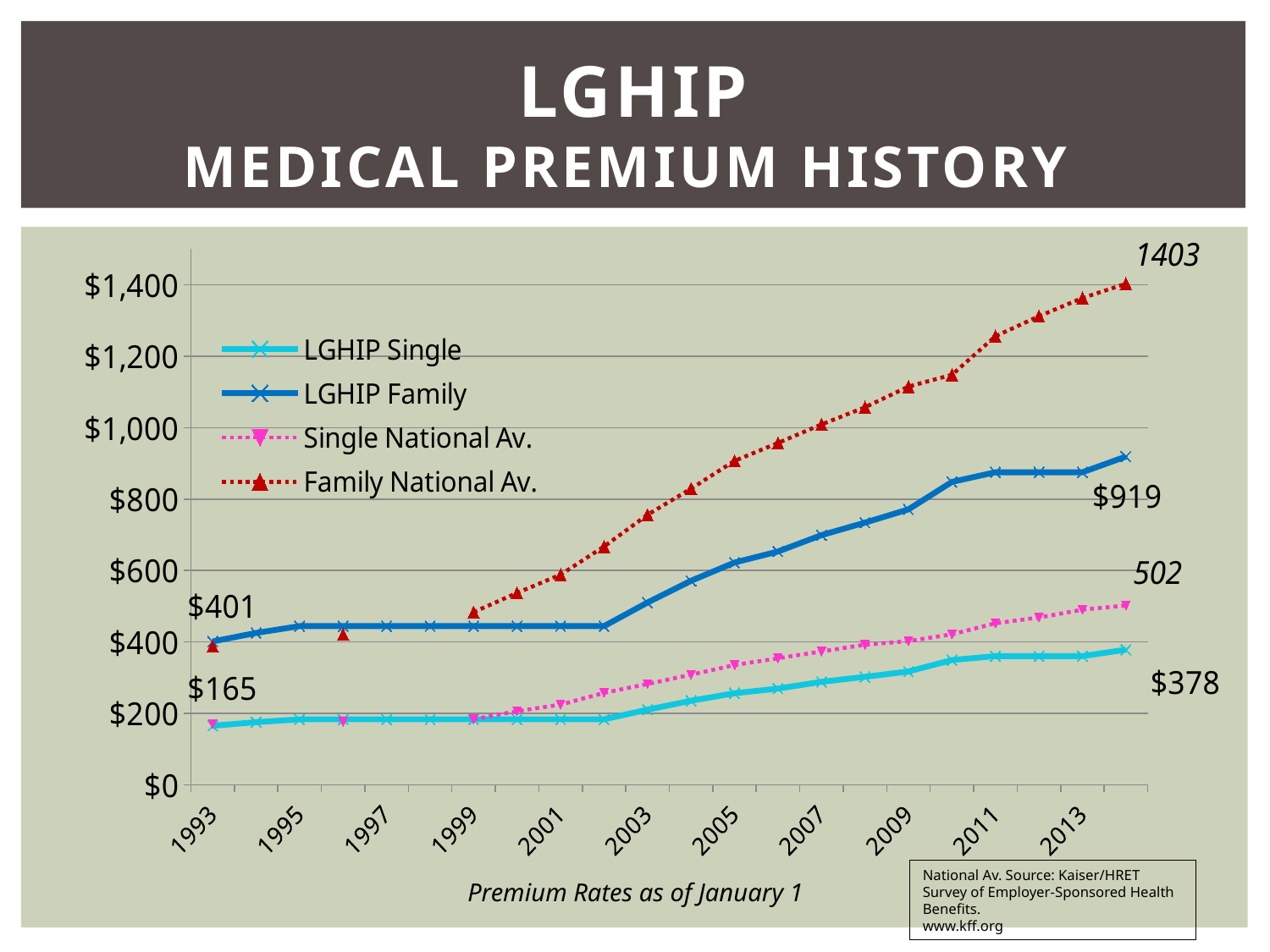
How many series does the legend list? 4 By how much did the LGHIP Single premium increase from its 1993 label ($165) to its final label ($378)? $213 What type of chart is shown on the slide? Line chart What is the final labeled value of the Family National Av. line? 1403 At the end of the chart, which is higher: the Family National Av. or the LGHIP Family premium? Family National Av. By how much did the LGHIP Family premium increase from its 1993 label ($401) to its final label ($919)? $518 What is the final labeled value of the LGHIP Family line? $919 Is the LGHIP Family value in 2007 greater or less than $600? greater What is the final labeled value of the Single National Av. line? 502 Is the Single National Av. value in 2005 greater or less than $400? less What was the LGHIP Family premium in 1993, as labeled on the chart? $401 What was the LGHIP Single premium in 1993, as labeled on the chart? $165